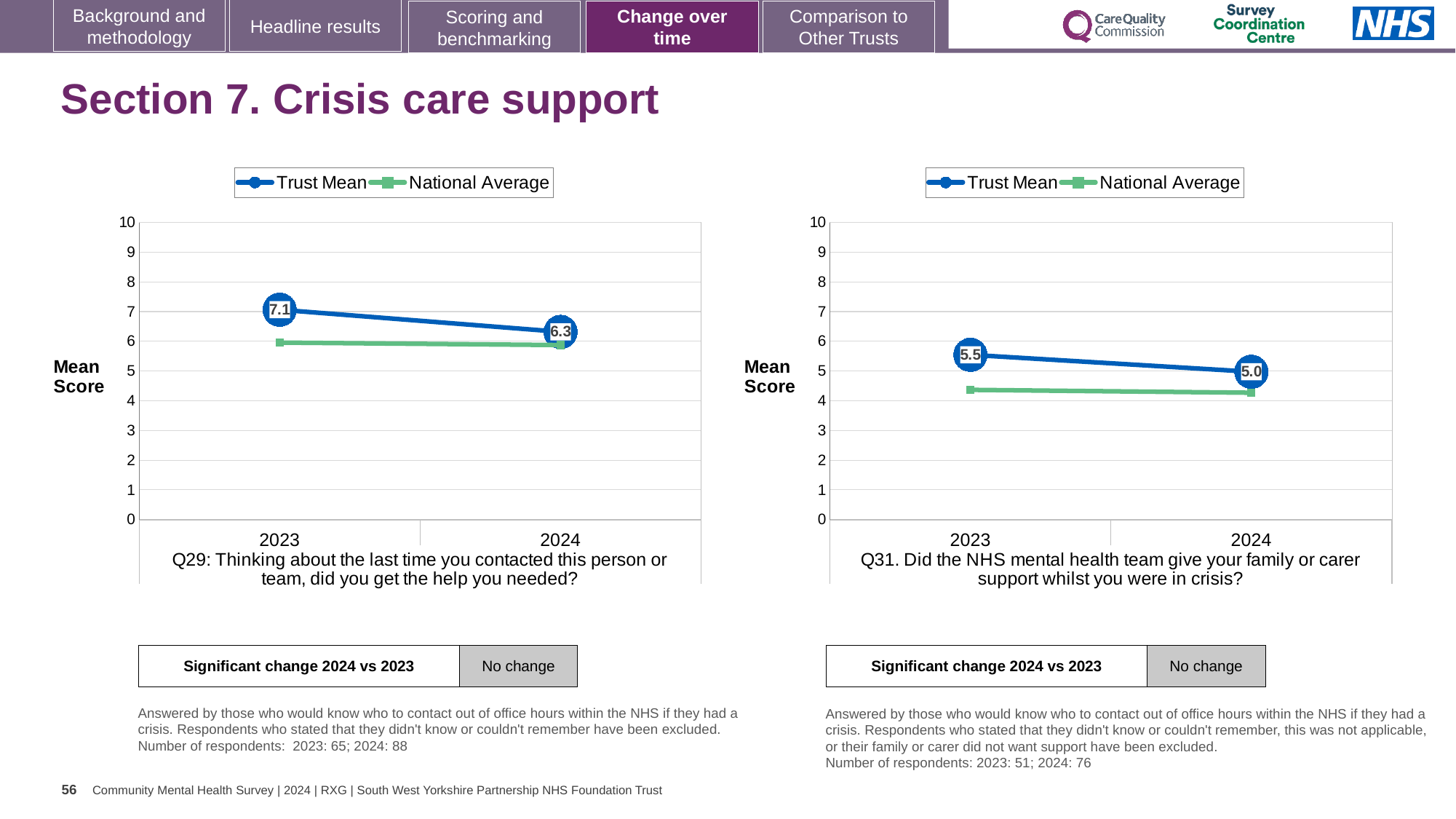
In the Q29 chart (left), is the National Average for 2023 greater or less than 7? less In the Q29 chart (left), by how much did the Trust Mean fall from 2023 to 2024? 0.8 In the Q31 chart (right), is the Trust Mean for 2023 higher or lower than the National Average for 2023? higher How many series does the legend of the Q29 chart (left) list? 2 In the Q31 chart (right), is the National Average for 2024 greater or less than 5? less In the Q29 chart (left), what is the Trust Mean for 2024? 6.3 In the Q29 chart (left), does the Trust Mean rise or fall from 2023 to 2024? fall What type of chart is the Q31 chart (right)? line chart In the Q29 chart (left), what is the Trust Mean for 2023? 7.1 In the Q31 chart (right), what is the Trust Mean for 2023? 5.5 In the Q31 chart (right), what is the Trust Mean for 2024? 5.0 In the Q31 chart (right), what is the difference between the Trust Mean in 2023 and 2024? 0.5